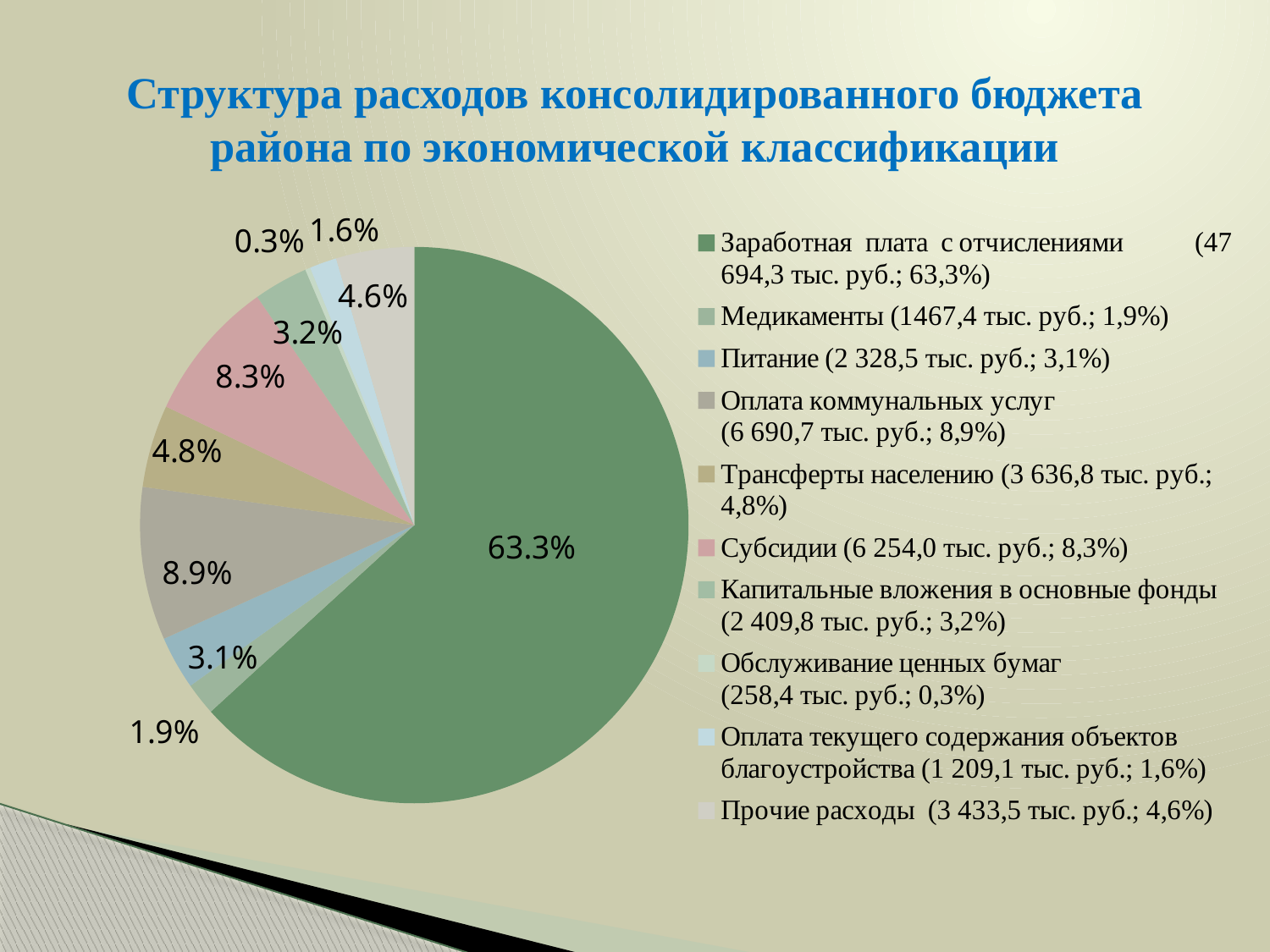
How many slices does the pie chart have? 10 What is the title of the slide containing the pie chart? Структура расходов консолидированного бюджета района по экономической классификации Which category has the largest slice of the pie? Заработная плата с отчислениями What share of the pie does "Заработная плата с отчислениями" take? 63.3% What share of the pie does "Обслуживание ценных бумаг" take? 0.3% Which slice is larger, "Питание" or "Трансферты населению"? Трансферты населению What is the difference in percentage points between the "Оплата коммунальных услуг" slice and the "Субсидии" slice? 0.6 According to the legend, what amount in thousand rubles corresponds to "Медикаменты"? 1467,4 тыс. руб. What share of the pie does "Субсидии" take? 8.3% Which category has the smallest slice of the pie? Обслуживание ценных бумаг What kind of chart is shown on the slide? pie chart